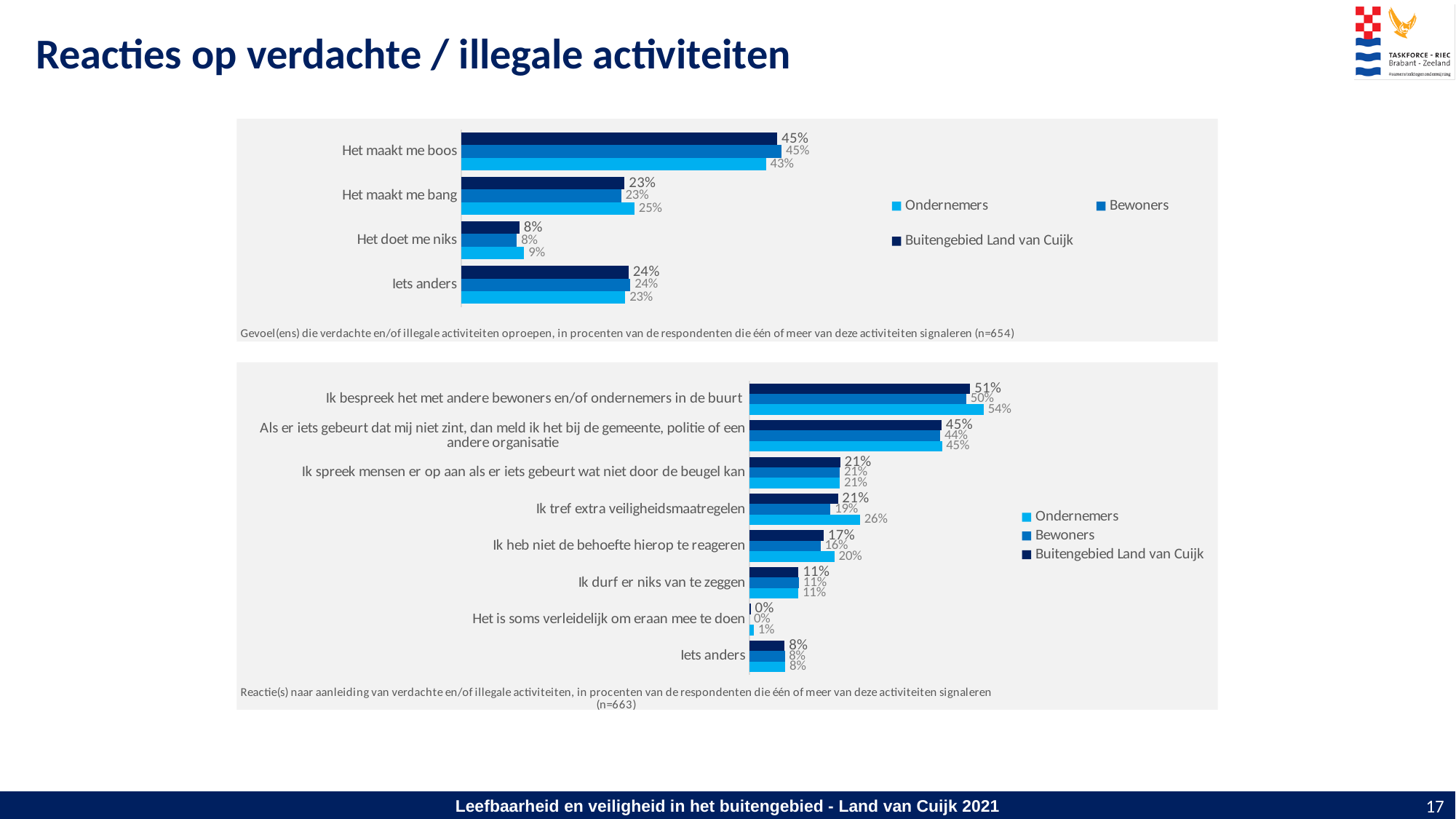
In the top chart, what is the difference between the Ondernemers and Bewoners values for 'Het maakt me bang'? 2% In the top chart, what is the value for Buitengebied Land van Cuijk for 'Het maakt me boos'? 45% What type of chart is the bottom chart? Bar chart In the bottom chart, how many series does the legend list? 3 In the top chart, what is the value for Ondernemers for 'Het maakt me bang'? 25% In the bottom chart, which category has the lowest value for Buitengebied Land van Cuijk? Het is soms verleidelijk om eraan mee te doen In the top chart, which category has the lowest value for Bewoners? Het doet me niks In the top chart, how many categories are shown? 4 In the bottom chart, how many categories are shown? 8 In the bottom chart, which category has the highest value for Ondernemers? Ik bespreek het met andere bewoners en/of ondernemers in de buurt In the bottom chart, what is the value for Bewoners for 'Ik heb niet de behoefte hierop te reageren'? 16% In the bottom chart, what is the value for Ondernemers for 'Ik tref extra veiligheidsmaatregelen'? 26%